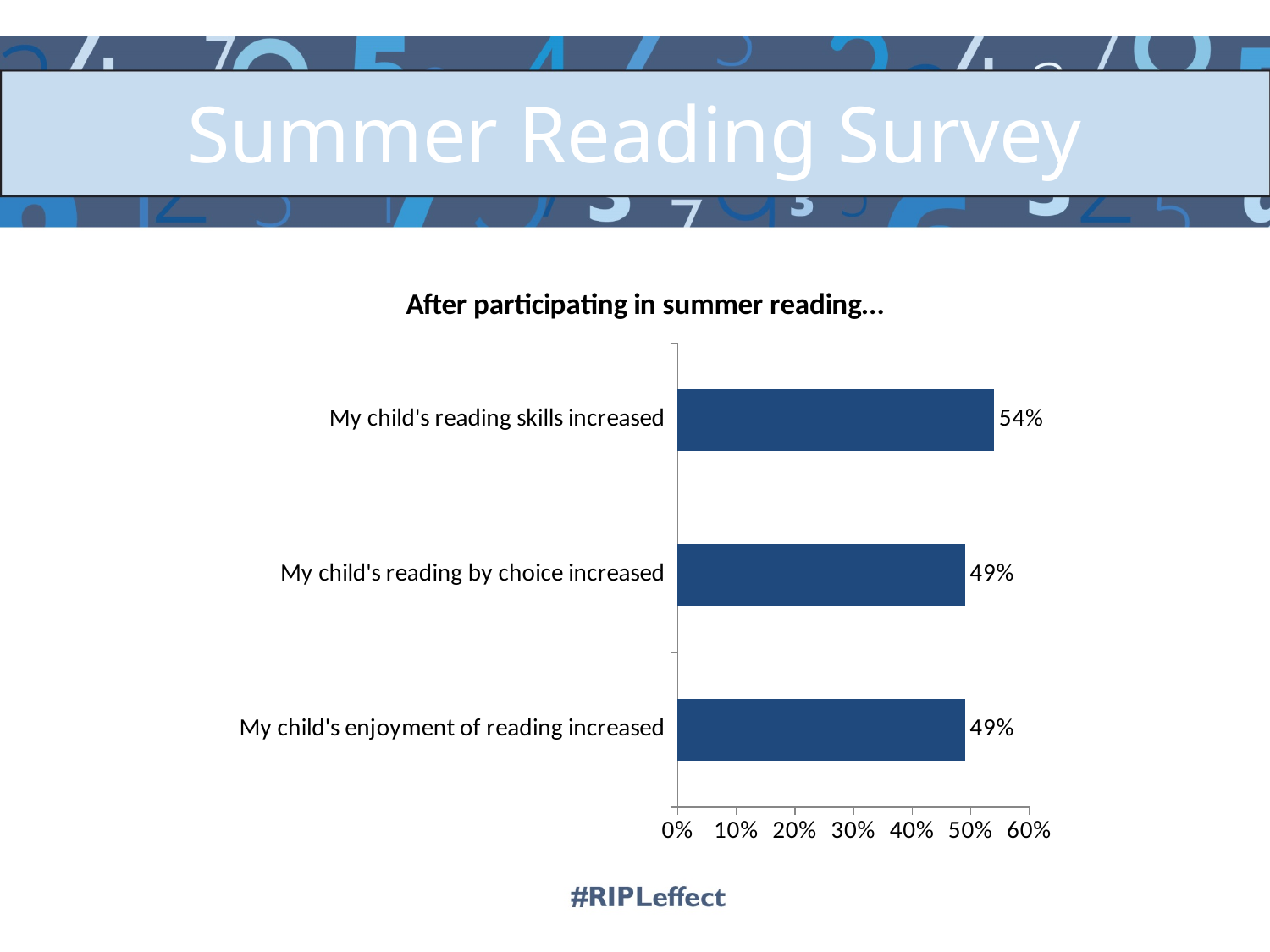
Is the value for "My child's reading skills increased" greater or less than 50%? greater What is the title of the chart? After participating in summer reading… What is the maximum value shown on the x axis? 60% What is the value for "My child's reading by choice increased"? 49% How many categories are shown in the chart? 3 Is the value for "My child's reading by choice increased" greater or less than 50%? less What is the value for "My child's enjoyment of reading increased"? 49% What kind of chart is shown on the slide? Bar chart Which category has the highest value? My child's reading skills increased What percentage of respondents said their child's reading skills increased? 54% What is the difference between the value for "My child's reading skills increased" and "My child's reading by choice increased"? 5% Which is larger: the value for "My child's reading skills increased" or "My child's enjoyment of reading increased"? My child's reading skills increased